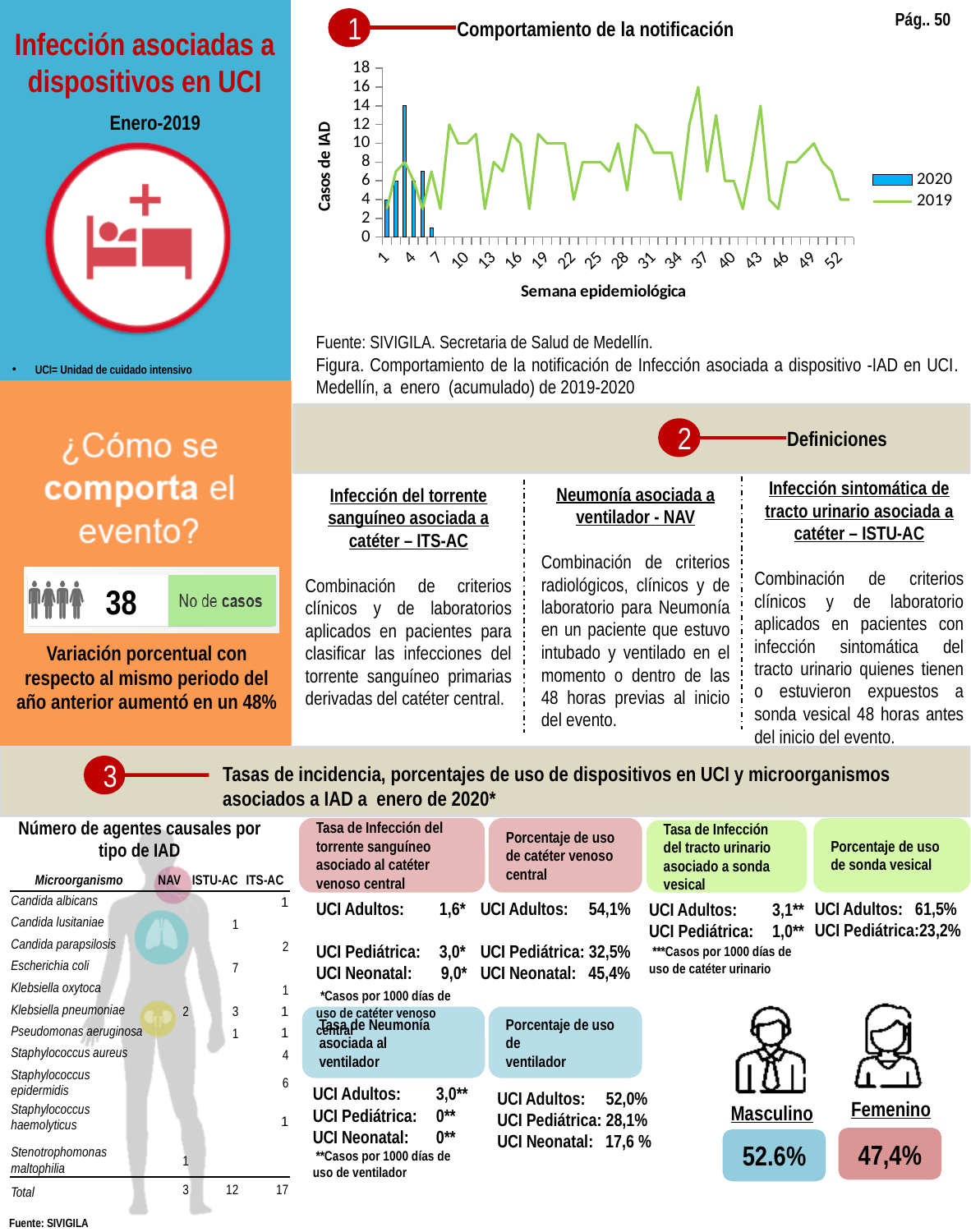
Up to which epidemiological week does the x axis of the chart extend? 52 What kind of chart is used to show the notification behaviour (Comportamiento de la notificación)? Combined bar and line chart In week 3, which series has the larger value, 2020 or 2019? 2020 Is the 2020 value for week 3 greater or less than 12? greater What is the label of the y axis of the chart? Casos de IAD How many series does the legend of the chart list? 2 What is the title of the chart on the slide? Comportamiento de la notificación Which series in the chart is drawn as bars? 2020 Is the 2019 value for week 52 greater or less than 6? less Is the highest value of the 2019 line greater or less than 14? greater In which epidemiological week do the 2020 bars reach their highest value? 3